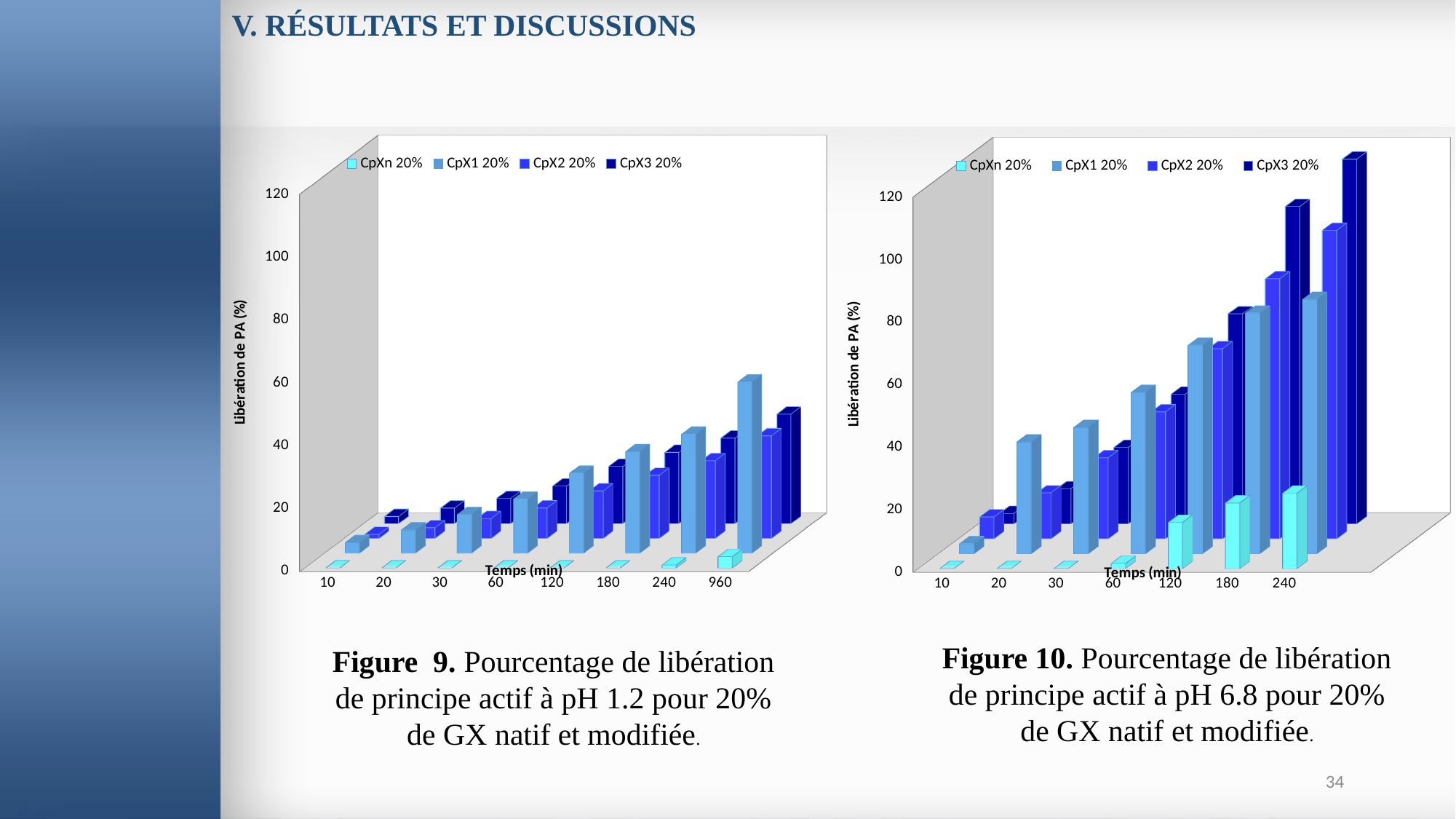
In Figure 9, do the values for CpX1 20% rise or fall as time increases along the x axis? rise What kind of chart is Figure 9? bar chart How many time categories are shown on the x axis of Figure 10? 7 In Figure 9, which series has the lowest values across all time points? CpXn 20% How many time categories are shown on the x axis of Figure 9? 8 In Figure 10, which is larger at 240 min: CpX3 20% or CpXn 20%? CpX3 20% What is the label of the y axis in Figure 10? Libération de PA (%) In Figure 9, is the value for CpX1 20% at 960 min greater or less than 40? greater In Figure 10, which series has the highest value at 240 min? CpX3 20% How many series does the legend of Figure 10 list? 4 In Figure 10, is the value for CpX1 20% at 120 min greater or less than 60? greater